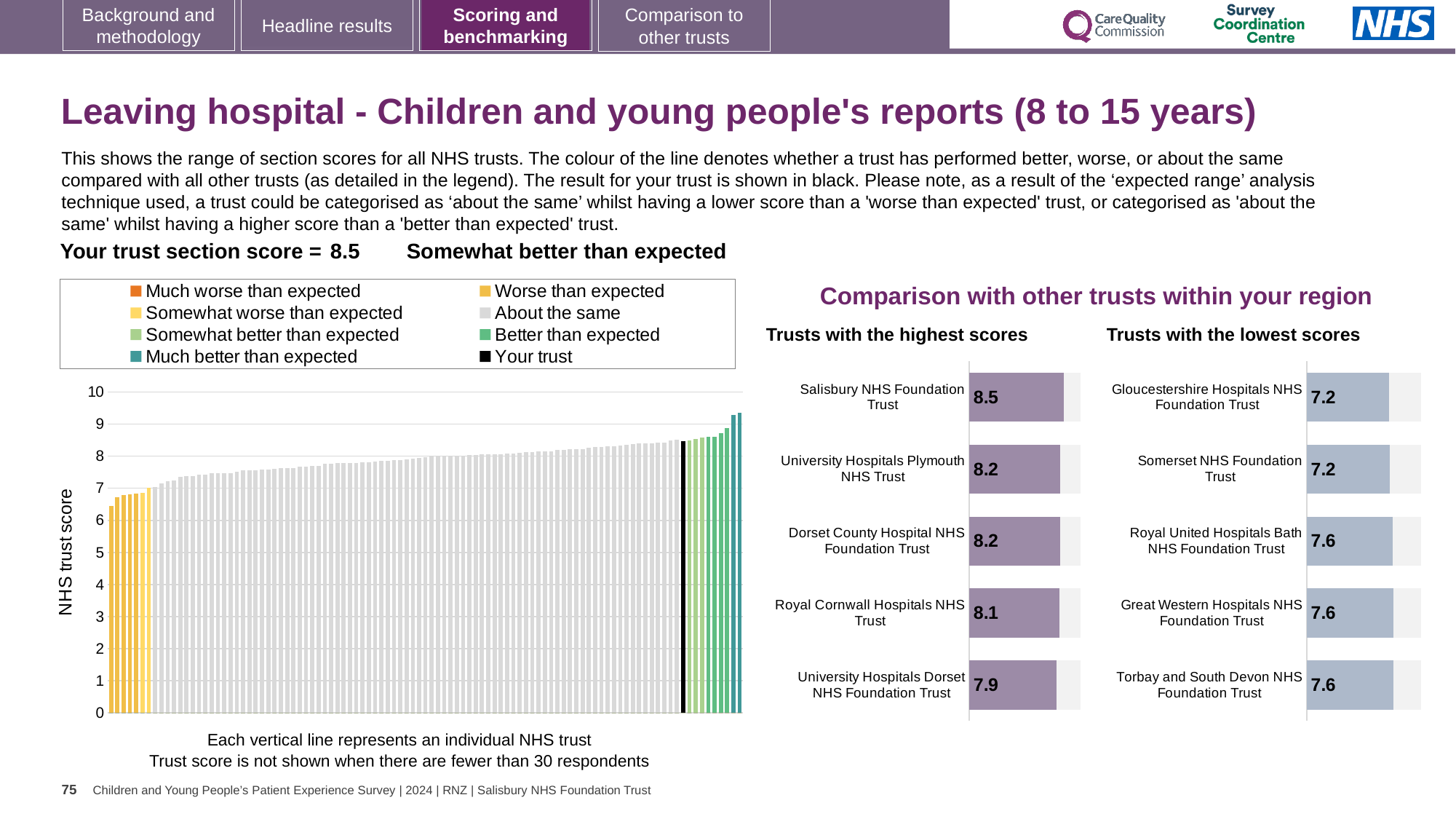
In the large chart on the left, do the trust scores rise or fall from left to right? Rise In the 'Trusts with the lowest scores' chart, what is the score for Torbay and South Devon NHS Foundation Trust? 7.6 What kind of chart is the large chart on the left showing the range of NHS trust scores? Bar chart In the 'Trusts with the highest scores' chart, what is the score for Salisbury NHS Foundation Trust? 8.5 In the large chart on the left, is the value of the leftmost bar greater or less than 7? less In the 'Trusts with the lowest scores' chart, which is larger: the score for Somerset NHS Foundation Trust or the score for Royal United Hospitals Bath NHS Foundation Trust? Royal United Hospitals Bath NHS Foundation Trust In the 'Trusts with the highest scores' chart, how many trusts are shown? 5 In the 'Trusts with the lowest scores' chart, what is the score for Gloucestershire Hospitals NHS Foundation Trust? 7.2 In the 'Trusts with the highest scores' chart, which trust has the highest score? Salisbury NHS Foundation Trust In the 'Trusts with the highest scores' chart, what is the difference between the scores of Salisbury NHS Foundation Trust and University Hospitals Dorset NHS Foundation Trust? 0.6 In the 'Trusts with the lowest scores' chart, what is the difference between the scores of Great Western Hospitals NHS Foundation Trust and Gloucestershire Hospitals NHS Foundation Trust? 0.4 In the 'Trusts with the highest scores' chart, what is the score for University Hospitals Dorset NHS Foundation Trust? 7.9